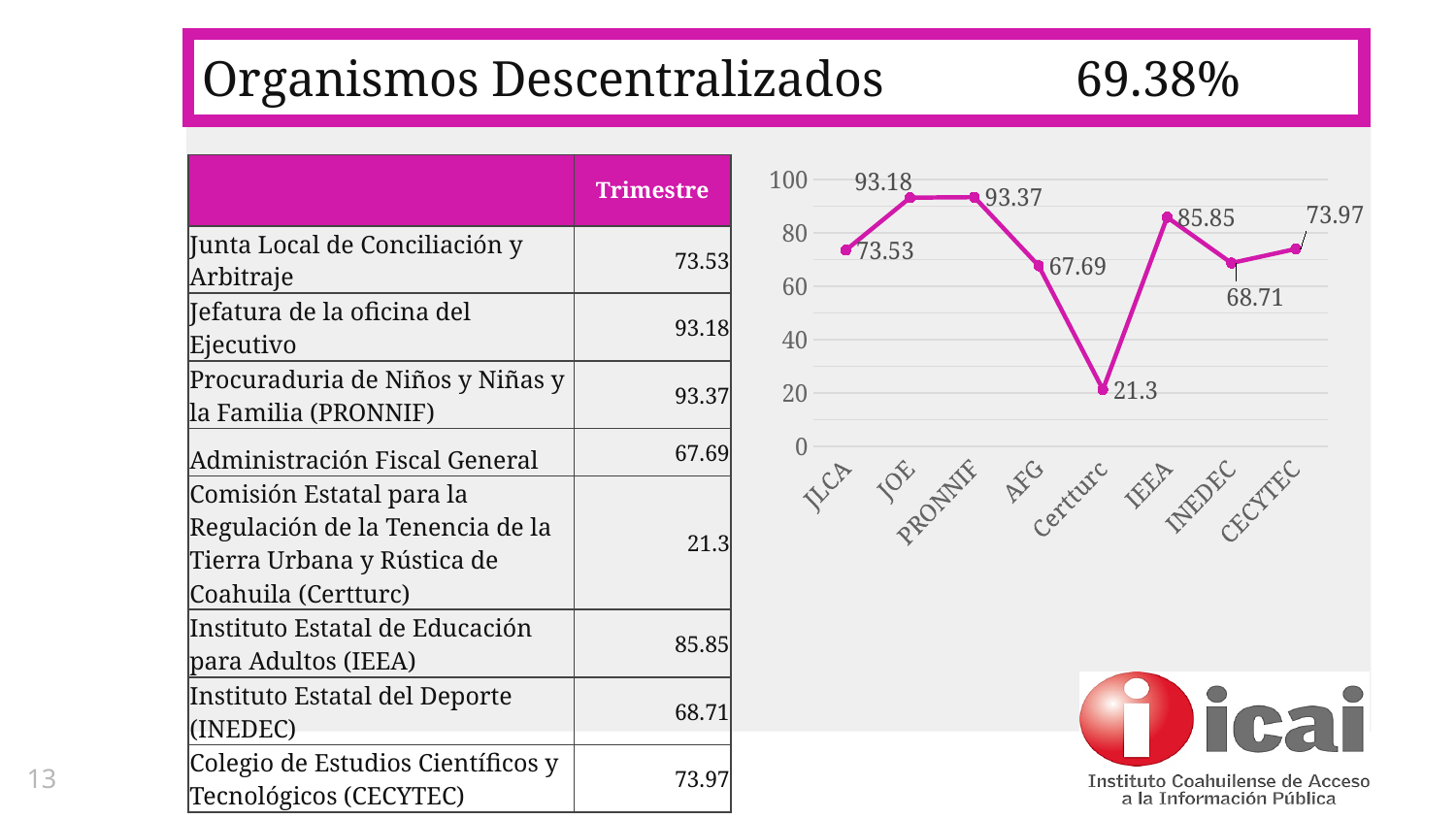
Is the value for Certturc in the line chart greater or less than 40? less Which category has the highest value in the line chart? PRONNIF Which is larger in the line chart, the value for AFG or the value for CECYTEC? CECYTEC What kind of chart is shown on the slide? line chart What is the difference between the values for IEEA and INEDEC in the line chart? 17.14 Which category has the lowest value in the line chart? Certturc How many categories are plotted on the x axis of the line chart? 8 What is the value for JLCA in the line chart? 73.53 What is the value for IEEA in the line chart? 85.85 What is the difference between the values for JOE and JLCA in the line chart? 19.65 What is the value for Certturc in the line chart? 21.3 Does the line rise or fall between PRONNIF and Certturc in the line chart? fall